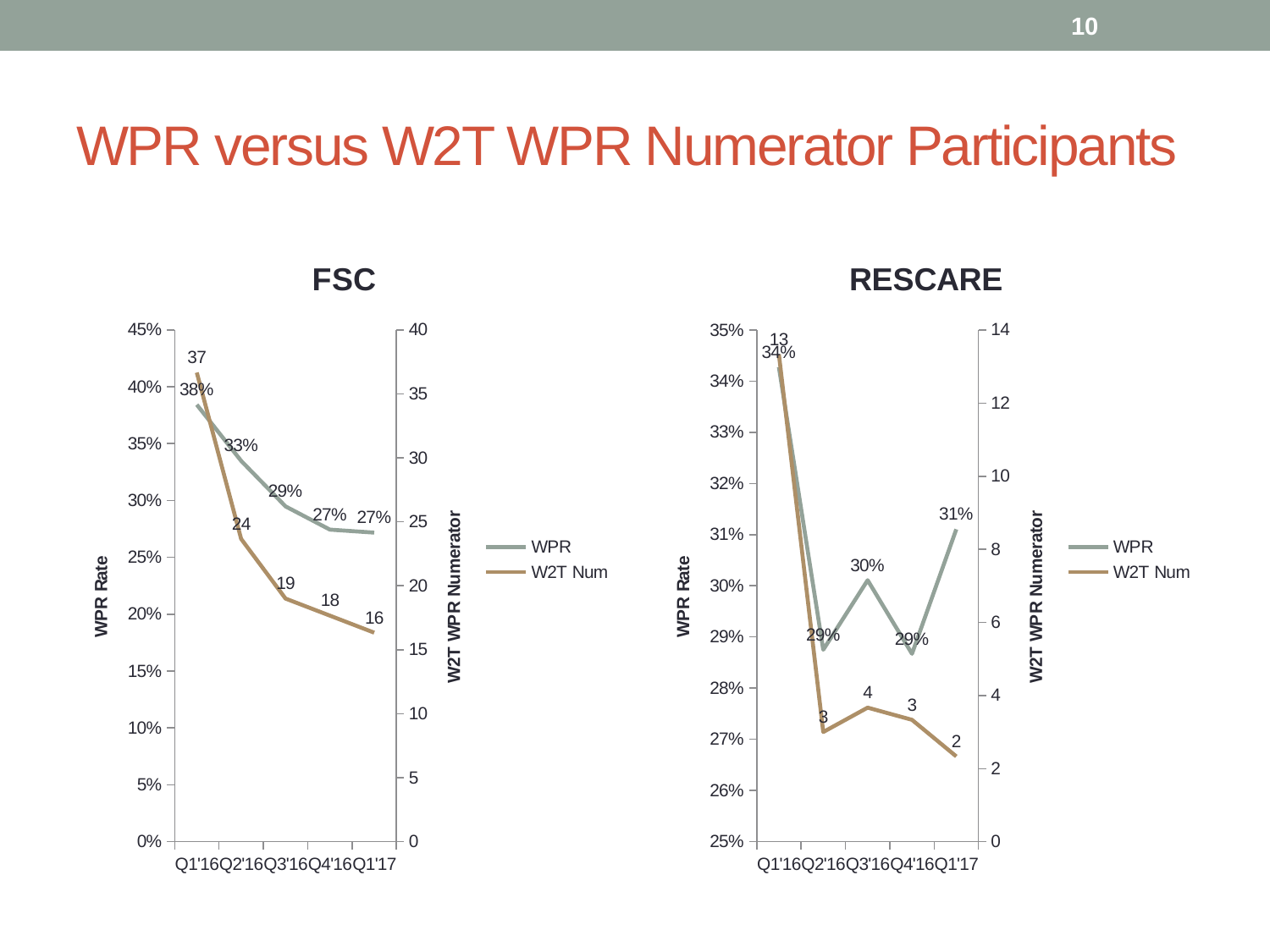
How many quarters are plotted on the x axis of the FSC chart? 5 In the RESCARE chart, which quarter has the highest W2T Num value? Q1'16 In the FSC chart, does the W2T Num series rise or fall from Q1'16 to Q1'17? Fall In the FSC chart, what is the W2T Num value for Q2'16? 24 In the RESCARE chart, which quarter has the lowest W2T Num value? Q1'17 How many series does the legend of the RESCARE chart list? 2 In the RESCARE chart, which is larger, the WPR value for Q3'16 or for Q1'17? Q1'17 In the FSC chart, what is the W2T Num value for Q3'16? 19 What kind of chart is the FSC chart? Line chart In the RESCARE chart, what is the WPR value for Q1'17? 31% In the FSC chart, what is the WPR value for Q1'16? 38% In the FSC chart, what is the difference between the W2T Num values for Q1'16 and Q1'17? 21